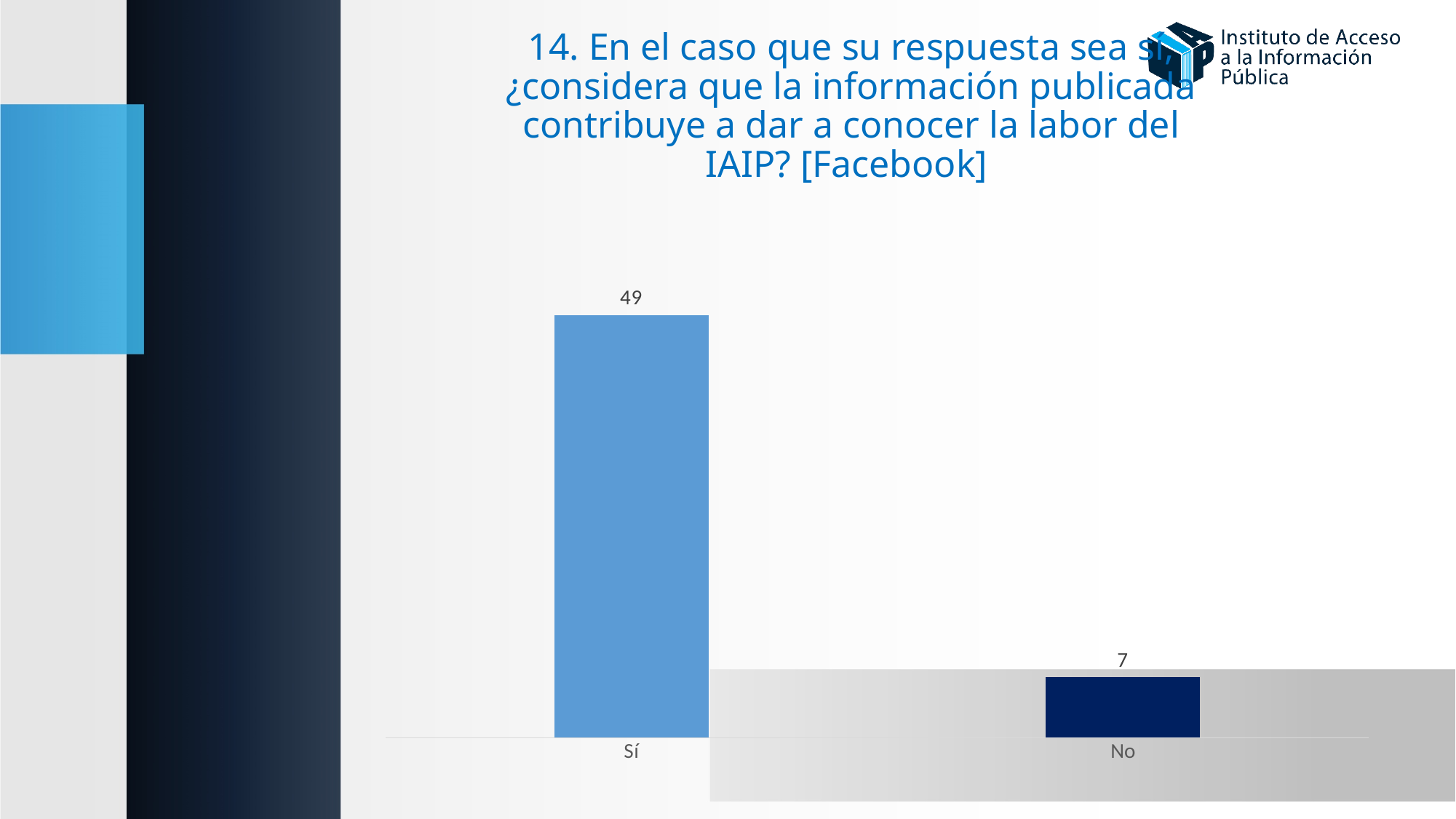
What kind of chart is shown on the slide? Bar chart Which is larger, the value for Sí or the value for No? Sí What is the value for No? 7 Which category has the lowest value? No What is the value for Sí? 49 What is the difference between the values for Sí and No? 42 What is the total of the values for Sí and No? 56 What colour is the bar for No? Dark blue How many categories are shown in the chart? 2 Which category has the highest value? Sí Which social network is named in brackets in the chart title? Facebook